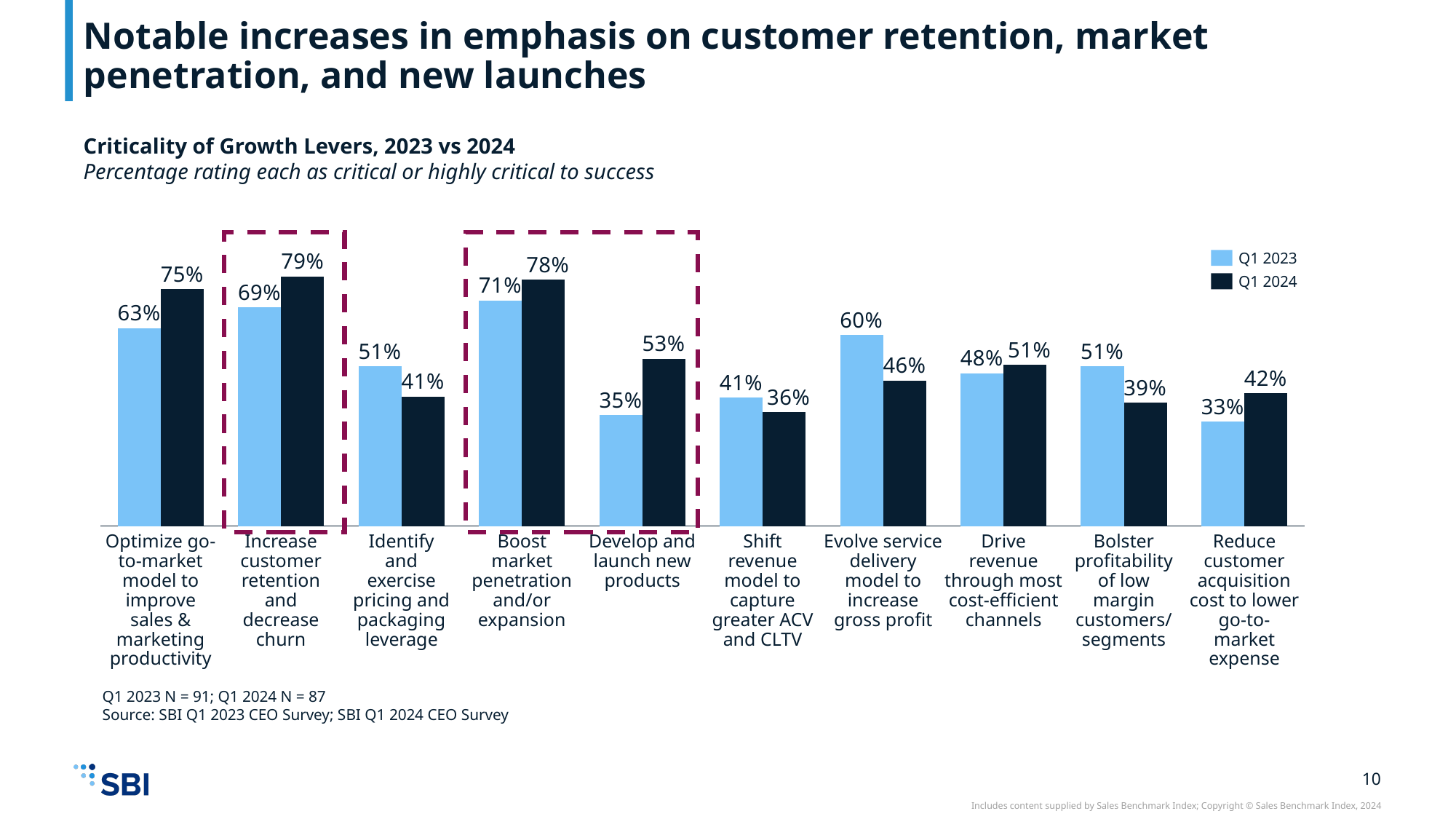
How many growth levers are shown on the x axis of the chart? 10 Which growth lever has the highest Q1 2024 value? Increase customer retention and decrease churn What type of chart is shown on the slide? Bar chart What is the Q1 2023 value for "Evolve service delivery model to increase gross profit"? 60% For "Identify and exercise pricing and packaging leverage", which is larger: the Q1 2023 value or the Q1 2024 value? Q1 2023 Which colour represents Q1 2024 in the chart? Dark navy What is the difference between the Q1 2023 and Q1 2024 values for "Evolve service delivery model to increase gross profit"? 14 percentage points By how many percentage points did "Develop and launch new products" increase from Q1 2023 to Q1 2024? 18 percentage points What is the Q1 2024 value for "Develop and launch new products"? 53% How many series does the legend list? 2 What is the Q1 2023 value for "Boost market penetration and/or expansion"? 71% Which growth lever has the lowest Q1 2023 value? Reduce customer acquisition cost to lower go-to-market expense